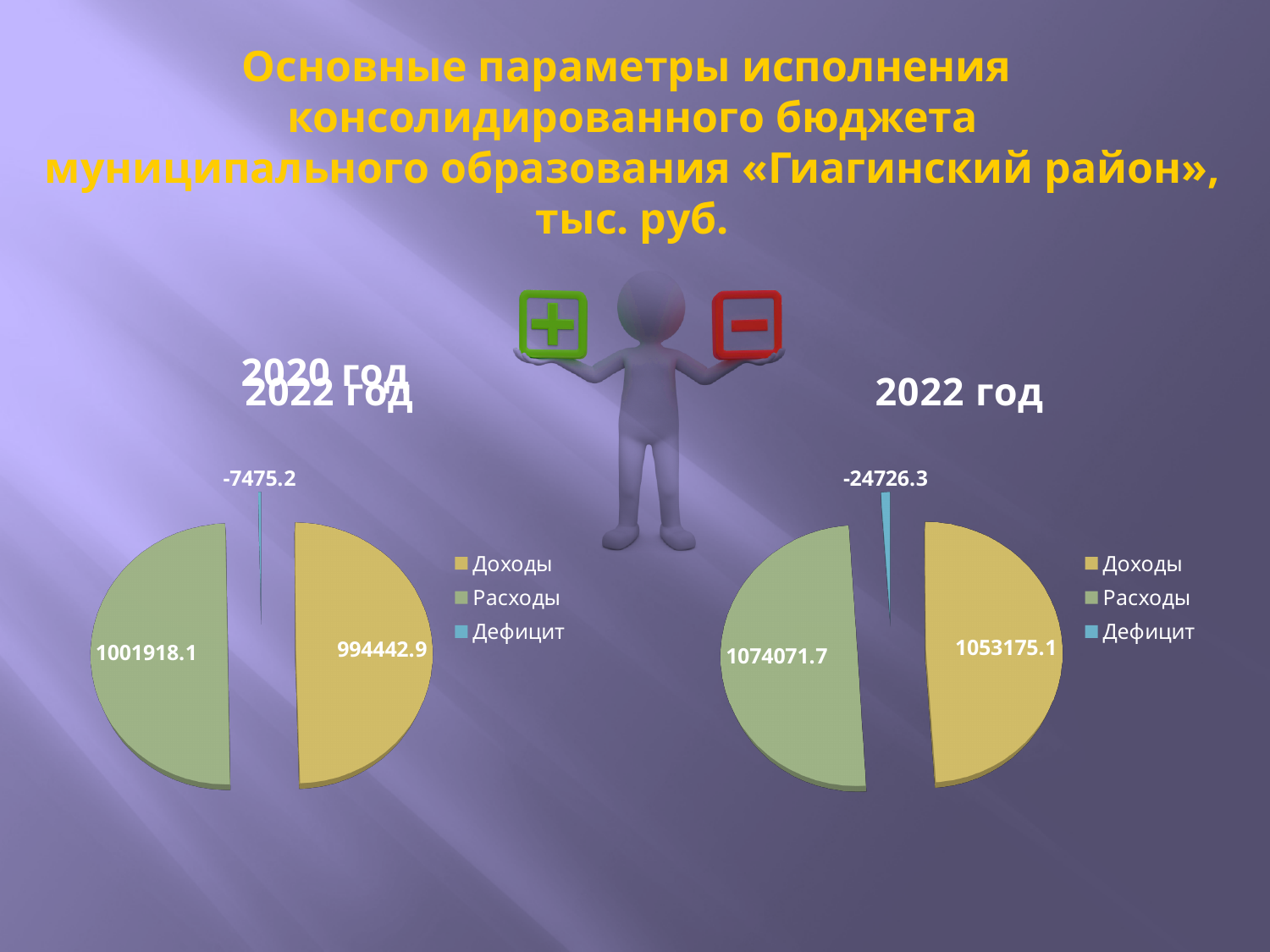
On the right pie chart (2022 год), which is larger, Доходы or Расходы? Расходы On the right pie chart (2022 год), what is the value for Доходы? 1053175.1 On the left pie chart, what is the value for Доходы? 994442.9 On the right pie chart (2022 год), which category has the highest value? Расходы On the left pie chart, what is the value for Дефицит? -7475.2 On the left pie chart, what is the value for Расходы? 1001918.1 On the right pie chart (2022 год), what is the difference between Расходы and Доходы? 20896.6 On the right pie chart (2022 год), what is the value for Дефицит? -24726.3 On the left pie chart, what is the difference between Расходы and Доходы? 7475.2 On the left pie chart, which category has the lowest value? Дефицит On the right pie chart (2022 год), what is the value for Расходы? 1074071.7 How many entries does the legend of the right pie chart (2022 год) list? 3